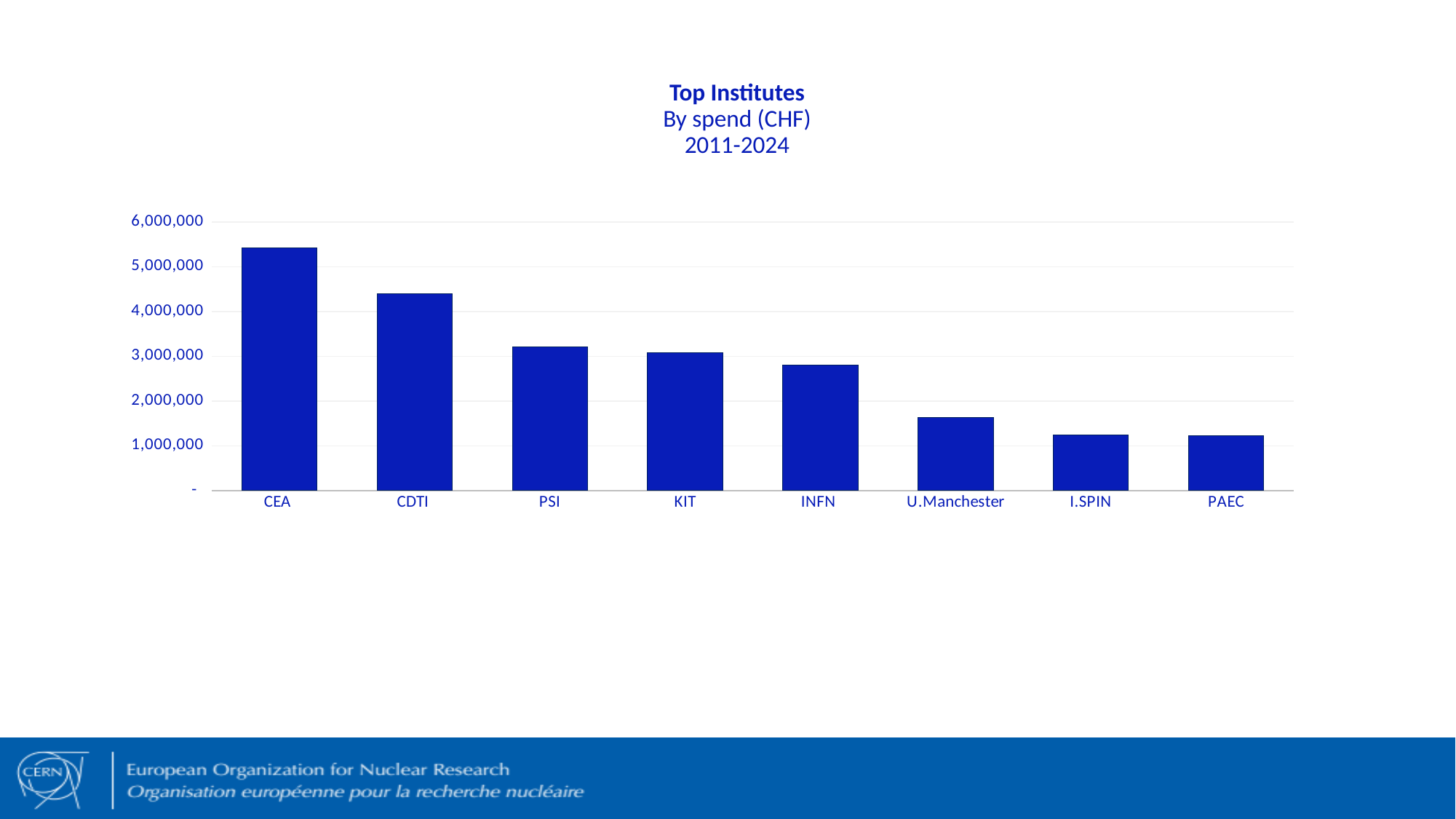
Is the value for CDTI greater or less than 4,000,000? greater Which has a larger spend, INFN or U.Manchester? INFN Do the values rise or fall from left to right across the chart? fall Is the value for PAEC greater or less than 1,000,000? greater Which has a larger spend, CDTI or PSI? CDTI Is the value for CEA greater or less than 5,000,000? greater How many institutes are shown on the chart? 8 What kind of chart is shown on the slide? bar chart Which institute has the highest spend? CEA What currency is the spend shown in, according to the chart title? CHF